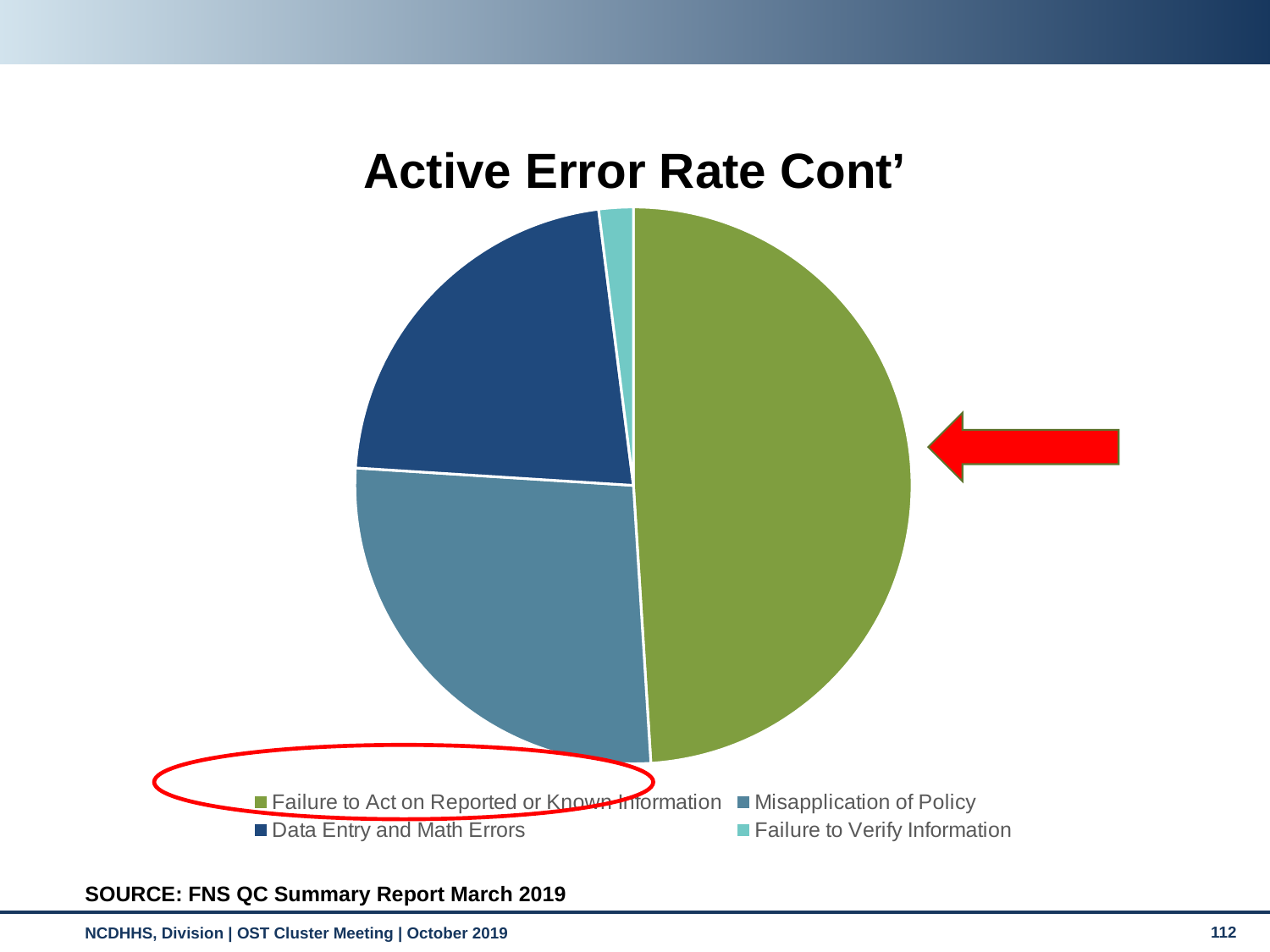
How many entries does the legend list? 4 Which slice is larger: Data Entry and Math Errors or Failure to Verify Information? Data Entry and Math Errors Which category has the smallest slice of the pie? Failure to Verify Information Which slice is larger: Failure to Act on Reported or Known Information or Misapplication of Policy? Failure to Act on Reported or Known Information What kind of chart is shown on the slide? Pie chart How many slices does the pie chart have? 4 Which legend entry is shown in green? Failure to Act on Reported or Known Information Which category has the largest slice of the pie? Failure to Act on Reported or Known Information Which slice is larger: Misapplication of Policy or Data Entry and Math Errors? Misapplication of Policy What is the title of the chart? Active Error Rate Cont'